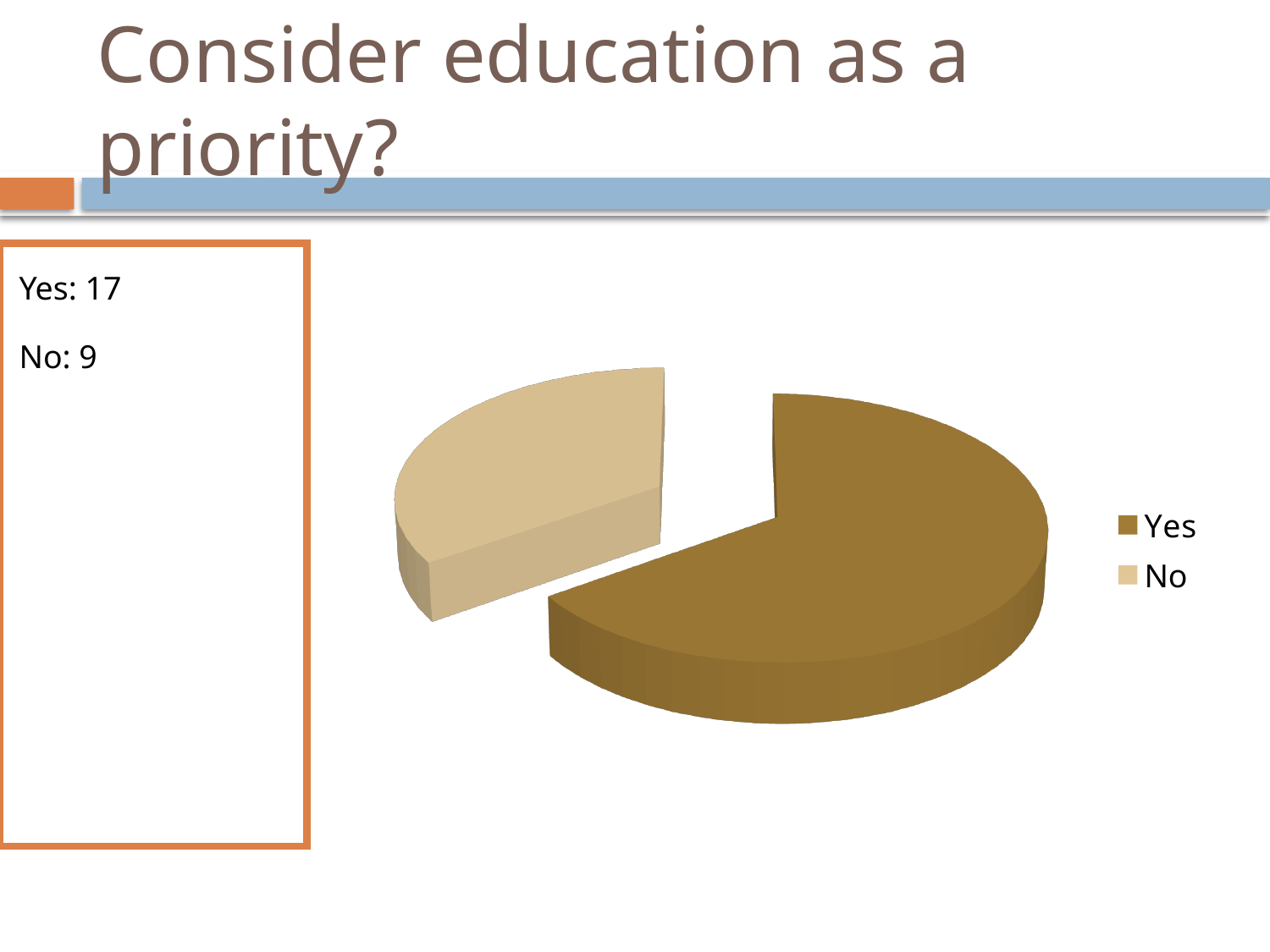
By how much does the Yes count exceed the No count on the slide? 8 What kind of chart is shown on the slide? pie chart What is the title of the slide containing the pie chart? Consider education as a priority? Which legend entry is shown in the darker brown colour in the pie chart? Yes How many slices does the pie chart have? 2 Which slice of the pie chart is the smallest? No Does the Yes slice take up more or less than half of the pie chart? more How many entries does the legend of the pie chart list? 2 Which slice of the pie chart is the largest? Yes Which is larger in the pie chart, the Yes slice or the No slice? Yes According to the slide, how many responses were No? 9 According to the slide, how many responses were Yes? 17